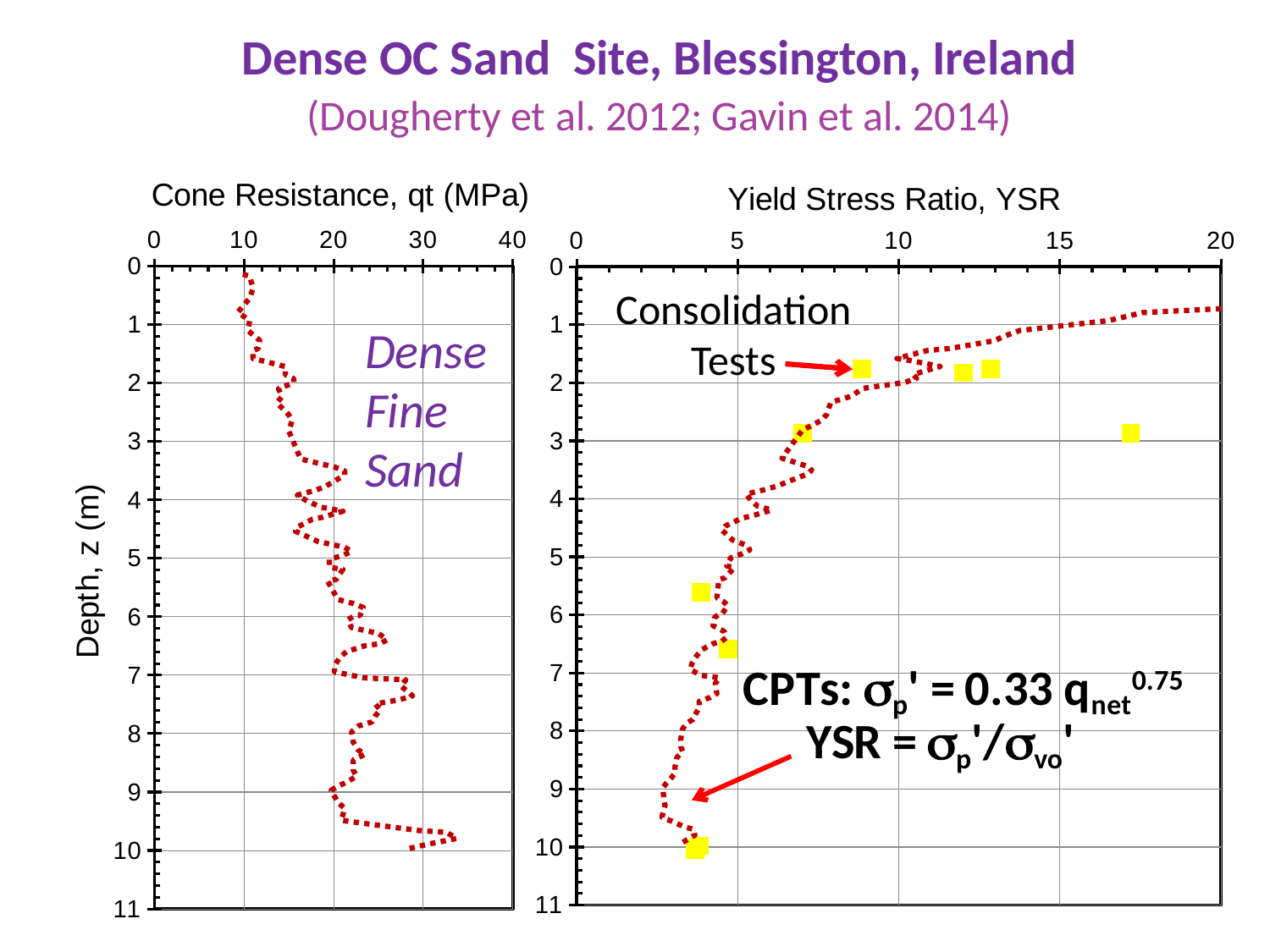
On the left chart, does cone resistance generally increase or decrease as depth increases? increase On the left chart, what kind of chart is used to plot cone resistance against depth? line chart On the right chart, does the YSR from the CPT profile generally increase or decrease as depth increases? decrease On the left chart, what is the title of the horizontal axis? Cone Resistance, qt (MPa) On the left chart, is the cone resistance at a depth of 1 m greater or less than 20 MPa? less On the right chart, is the YSR from the CPT profile at a depth of 9 m greater or less than 5? less On the right chart, what is the title of the horizontal axis? Yield Stress Ratio, YSR On the right chart, what is the maximum value shown on the horizontal YSR axis? 20